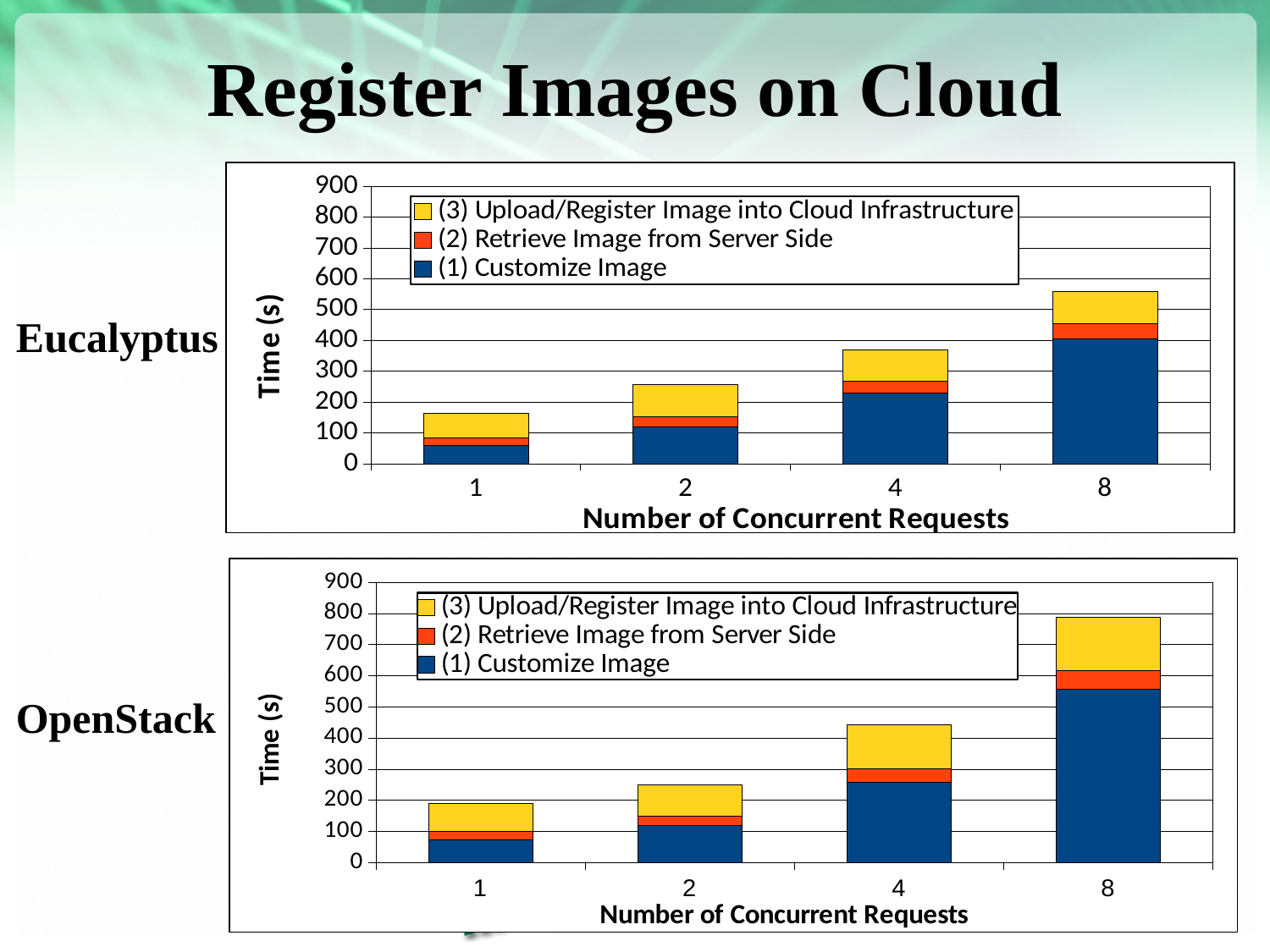
In the Eucalyptus chart, is the total time for 8 concurrent requests greater or less than 500? greater In the OpenStack chart, is the total time for 8 concurrent requests greater or less than 700? greater In the OpenStack chart, is the total time for 4 concurrent requests greater or less than 500? less What kind of chart is the Eucalyptus chart? Stacked bar chart How many series does the legend of the Eucalyptus chart list? 3 In the Eucalyptus chart, which number of concurrent requests has the tallest total bar? 8 How many categories are shown on the x axis of the OpenStack chart? 4 In the Eucalyptus chart, which series is shown in blue? (1) Customize Image In the Eucalyptus chart, which has the larger total time: 2 concurrent requests or 4 concurrent requests? 4 concurrent requests In the OpenStack chart, does the total time rise or fall as the number of concurrent requests increases? Rises In the OpenStack chart, which number of concurrent requests has the shortest total bar? 1 What is the label of the y axis on the OpenStack chart? Time (s)